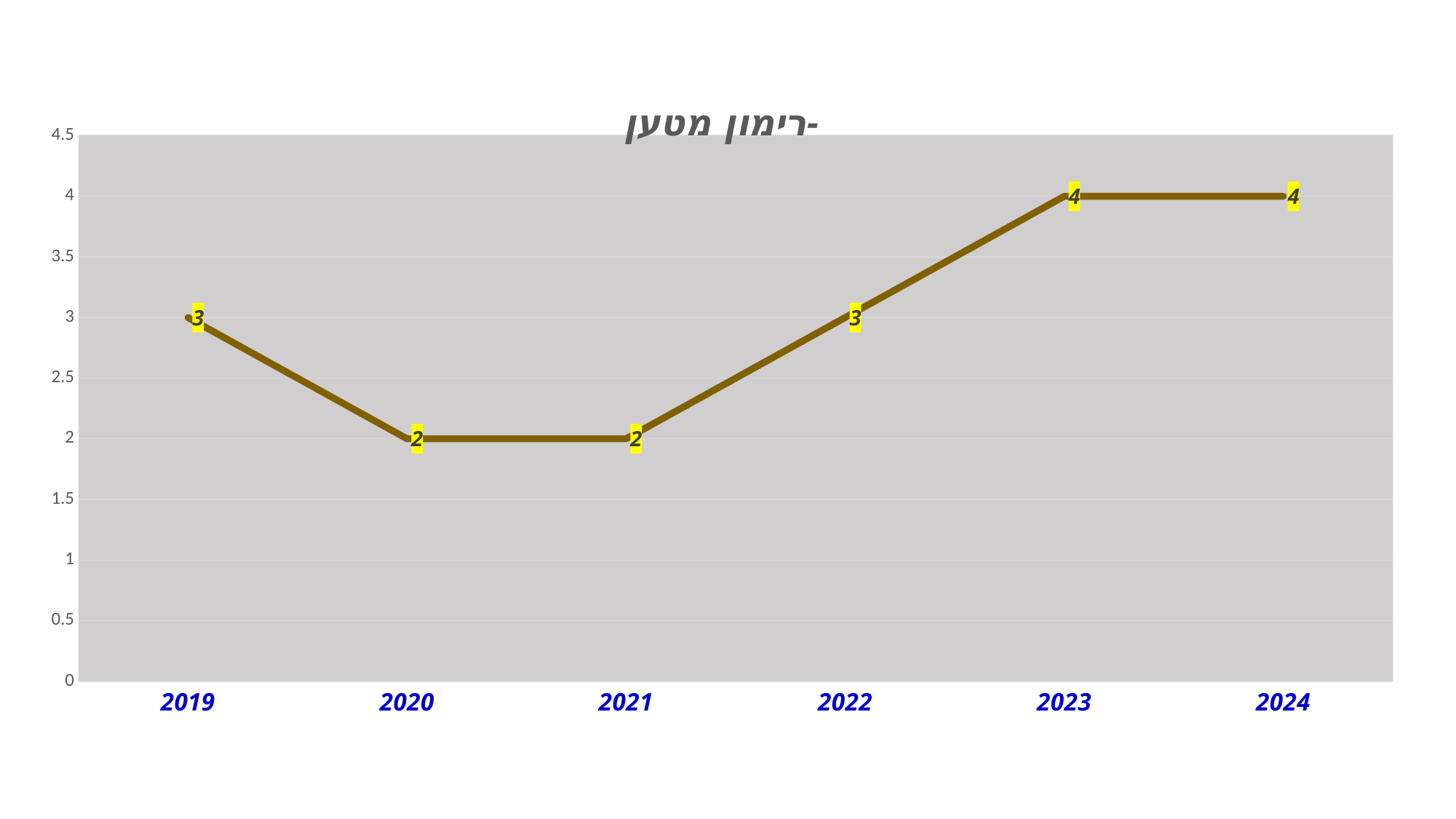
What is the value for 2021? 2 What is the title of the chart? רימון מטען- Which year has the lowest value? 2020 and 2021 What is the difference between the values for 2023 and 2020? 2 What is the difference between the values for 2022 and 2019? 0 How many years are plotted on the x axis? 6 What kind of chart is shown on the slide? line chart Do the values rise or fall from 2021 to 2023? rise Which is larger, the value for 2019 or the value for 2020? 2019 Is the value for 2023 greater or less than 3.5? greater What is the value for 2024? 4 What is the value for 2019? 3